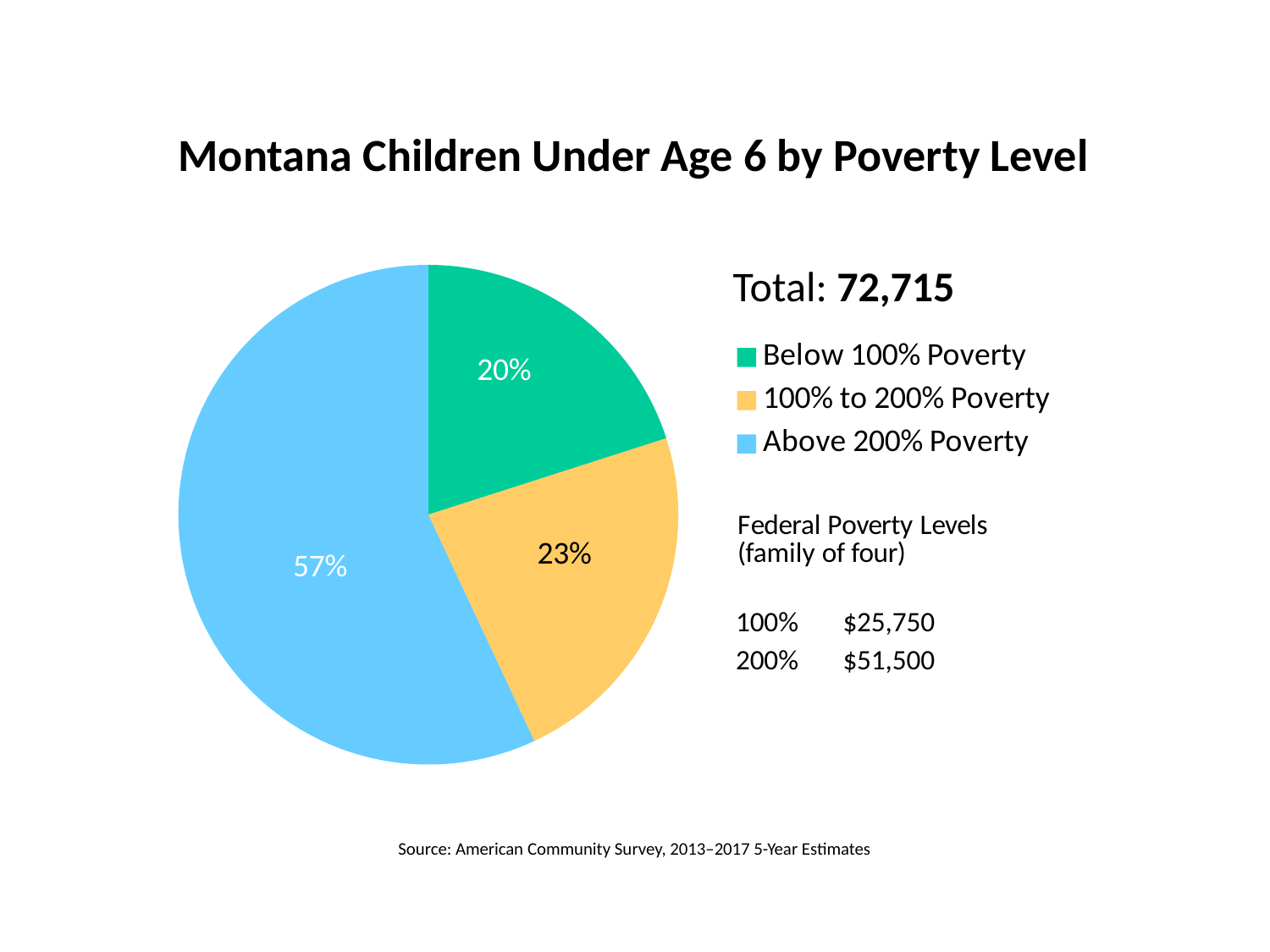
What kind of chart is shown on the slide? Pie chart What is the total number of Montana children under age 6 shown on the slide? 72,715 Which poverty level category has the smallest slice of the pie? Below 100% Poverty What share of Montana children under age 6 are in the 100% to 200% Poverty group? 23% What share of Montana children under age 6 are Below 100% Poverty? 20% How many categories does the pie chart show? 3 Which poverty level category has the largest slice of the pie? Above 200% Poverty Which is larger: the Below 100% Poverty slice or the 100% to 200% Poverty slice? 100% to 200% Poverty What colour is the Above 200% Poverty slice? Light blue What is the difference in percentage points between the Above 200% Poverty slice and the 100% to 200% Poverty slice? 34 percentage points What is the difference in percentage points between the 100% to 200% Poverty slice and the Below 100% Poverty slice? 3 percentage points What share of Montana children under age 6 are Above 200% Poverty? 57%